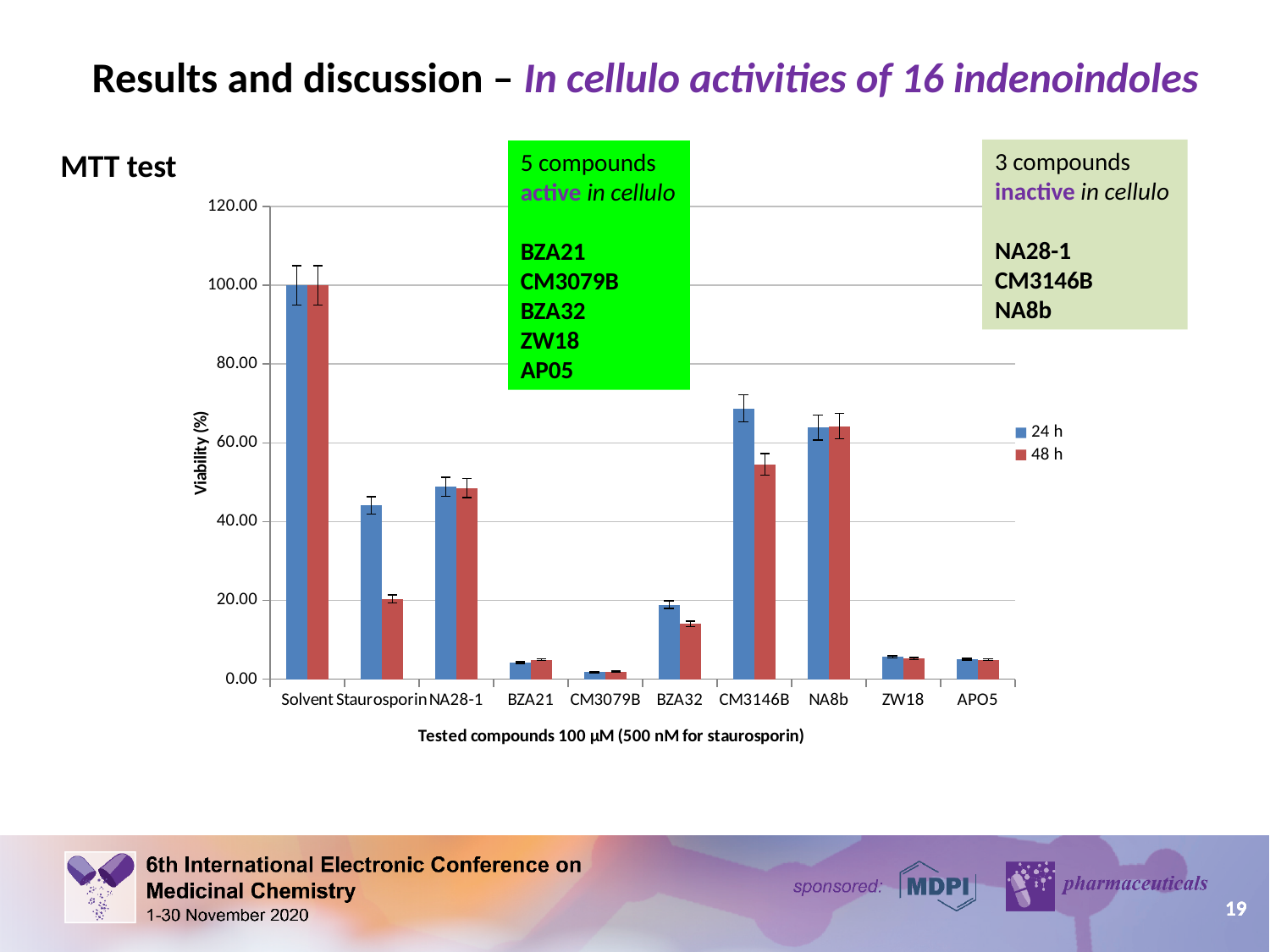
Is the 48 h viability for CM3146B greater or less than 60? less What is the label of the y axis of the chart? Viability (%) Is the 24 h viability for CM3146B greater or less than 60? greater Which colour represents the 48 h series in the chart? red Which category has the lowest viability at 24 h? CM3079B What is the viability (%) for Solvent at 24 h? 100.00 For Staurosporin, which is larger: the 24 h viability or the 48 h viability? 24 h How many series does the chart legend list? 2 Which category has the highest viability in the chart? Solvent What kind of chart is shown on the slide? bar chart How many tested compounds (categories) are shown on the x axis of the chart? 10 Is the 24 h viability for BZA21 greater or less than 20? less